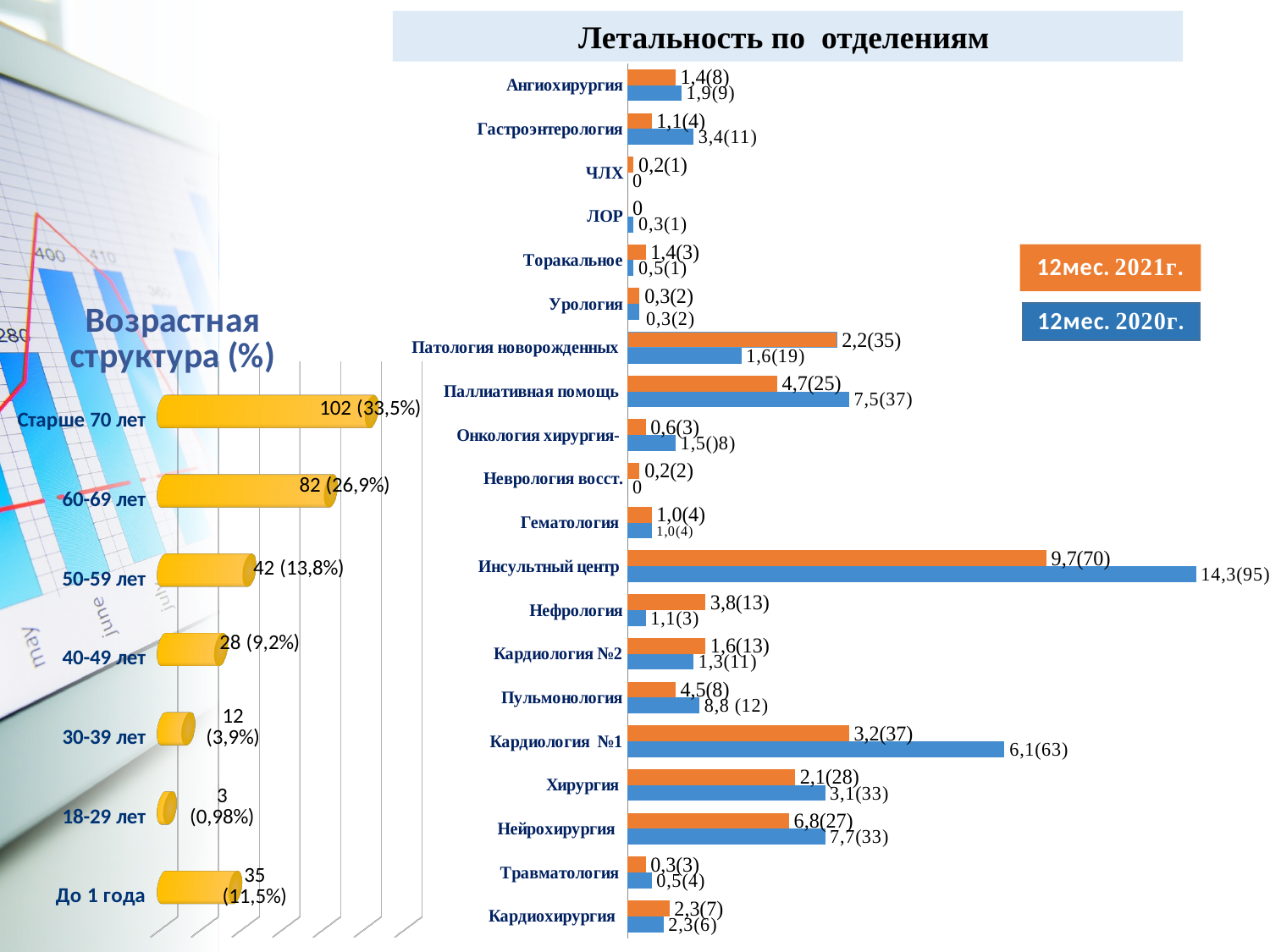
What kind of chart is the 'Возрастная структура (%)' chart on the left of the slide? bar chart How many series does the legend of the 'Летальность по отделениям' chart list? 2 How many age categories are shown in the 'Возрастная структура (%)' chart? 7 In the 'Возрастная структура (%)' chart, what is the difference between the counts for 'Старше 70 лет' and '60-69 лет'? 20 In the 'Возрастная структура (%)' chart, which age category has the highest value? Старше 70 лет How many departments are shown in the 'Летальность по отделениям' chart? 20 In the 'Летальность по отделениям' chart, what is the value for 'Нейрохирургия' in the '12мес. 2021г.' series? 6,8(27) In the 'Возрастная структура (%)' chart, which age category has the lowest value? 18-29 лет In the 'Летальность по отделениям' chart, which department has the highest value in the '12мес. 2021г.' series? Инсультный центр In the 'Летальность по отделениям' chart, which series has the larger value for 'Паллиативная помощь'? 12мес. 2020г. In the 'Возрастная структура (%)' chart, what is the value shown for 'Старше 70 лет'? 102 (33,5%) In the 'Летальность по отделениям' chart, what is the value for 'Инсультный центр' in the '12мес. 2020г.' series? 14,3(95)